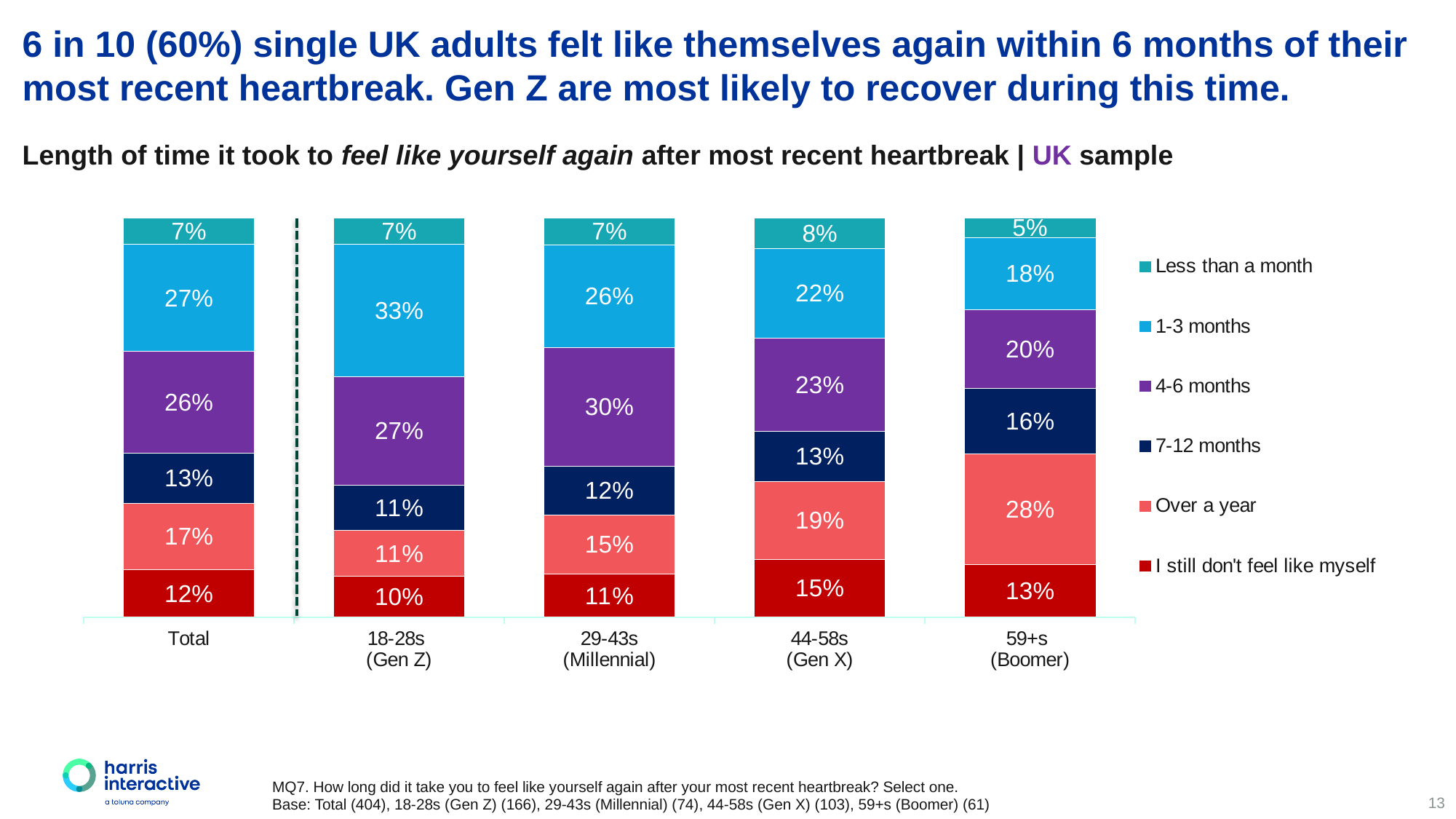
Does the 'I still don't feel like myself' percentage rise or fall from 18-28s (Gen Z) to 44-58s (Gen X)? Rise Which is larger: the 'Over a year' percentage for 44-58s (Gen X) or for 29-43s (Millennial)? 44-58s (Gen X) How many age groups (including Total) are shown on the x axis? 5 What kind of chart is shown on the slide? Stacked bar chart Which legend entry is shown in dark red? I still don't feel like myself How many series does the legend list? 6 What is the difference between the 1-3 months percentage for 18-28s (Gen Z) and 59+s (Boomer)? 15 percentage points Which age group has the highest percentage for 4-6 months? 29-43s (Millennial) Which age group has the lowest percentage for 'Less than a month'? 59+s (Boomer) What percentage of the Total sample still don't feel like themselves? 12% What percentage of the 18-28s (Gen Z) group took 1-3 months to feel like themselves again? 33% What percentage of the 59+s (Boomer) group said it took over a year? 28%